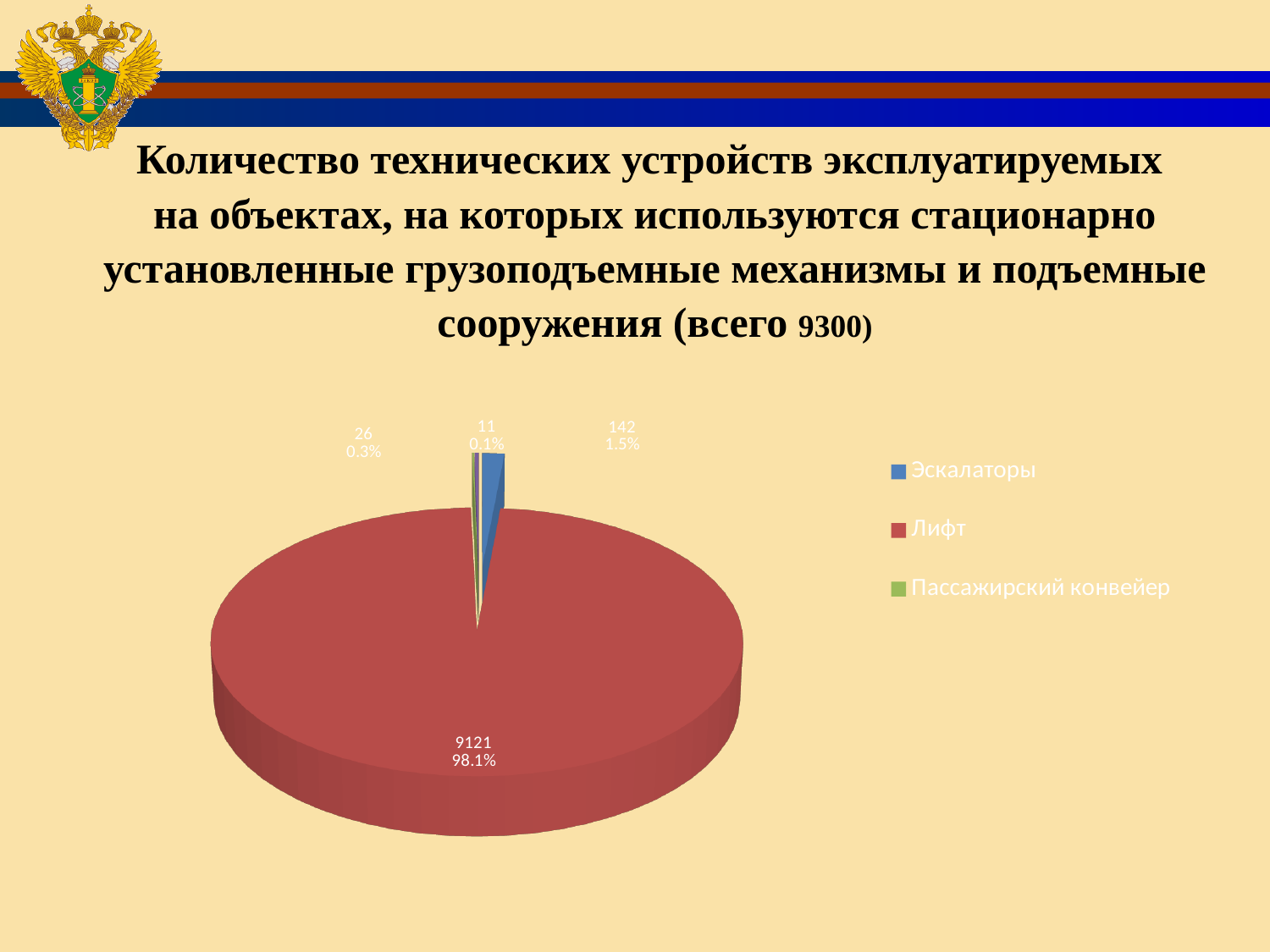
What is the value for Эскалаторы? 142 What is the difference between the values for Лифт and Эскалаторы? 8979 What colour is the slice for Лифт? red What is the smallest value labelled on the pie chart? 11 What share of the pie does Эскалаторы represent? 1.5% How many entries does the legend list? 3 Which is larger, the value for Лифт or the value for Эскалаторы? Лифт What is the value for Лифт? 9121 Which category has the largest slice of the pie? Лифт What is the total number of devices stated in the chart title? 9300 What share of the pie does Лифт represent? 98.1% What kind of chart is shown on the slide? pie chart